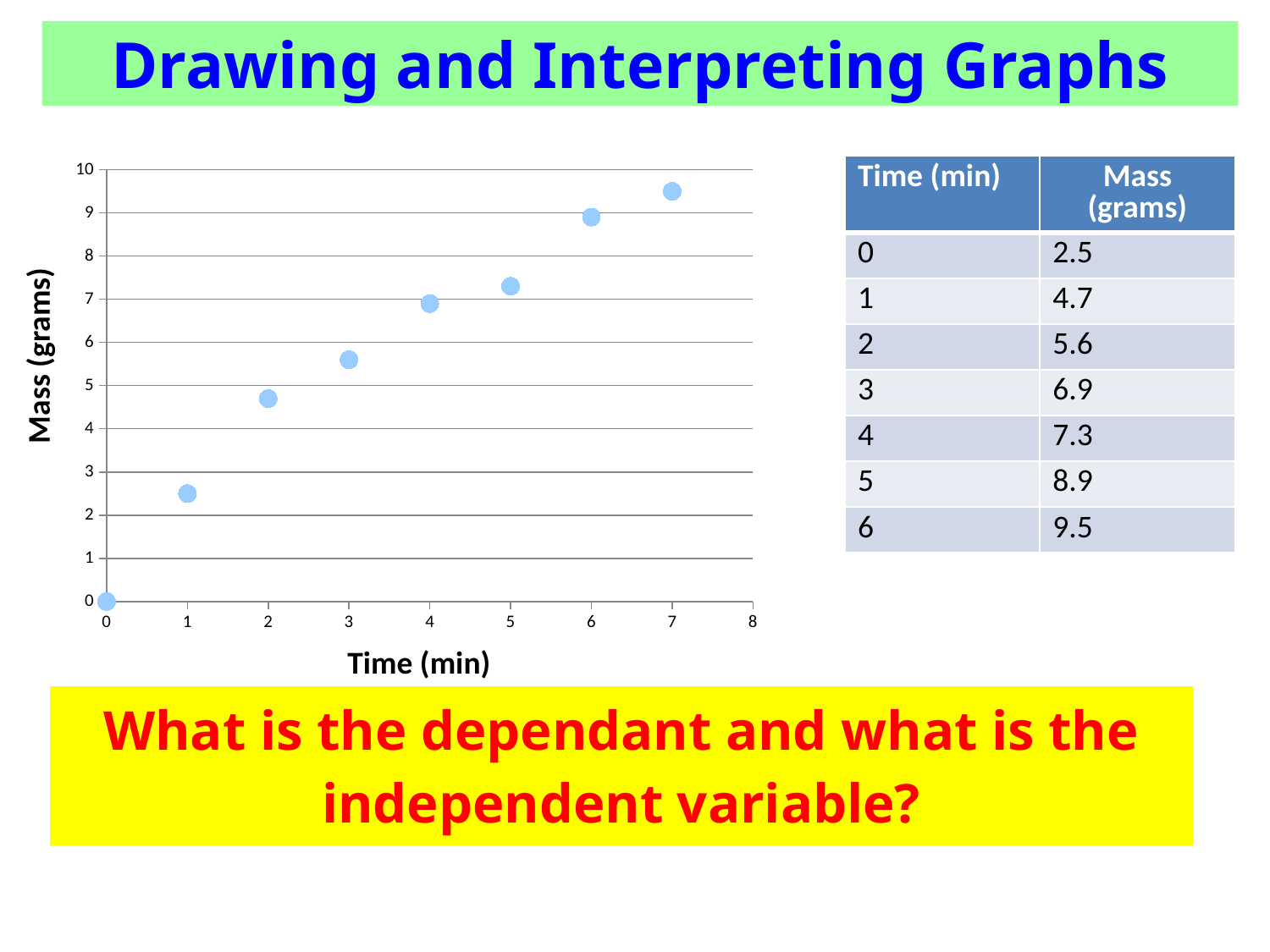
What kind of chart is shown on the slide? scatter plot Is the plotted mass at time 3 min greater or less than 6? less Do the plotted mass values rise or fall as time increases along the x axis? rise Is the plotted mass at time 2 min greater or less than 5? less At which time (min) is the plotted mass lowest? 0 Which has the larger plotted mass: time 4 min or time 2 min? time 4 min At which time (min) is the plotted mass highest? 7 Is the plotted mass at time 1 min greater or less than 2? greater How many data points are plotted on the chart? 8 What is the plotted mass at time 0 min? 0 What is the label on the vertical axis of the chart? Mass (grams)